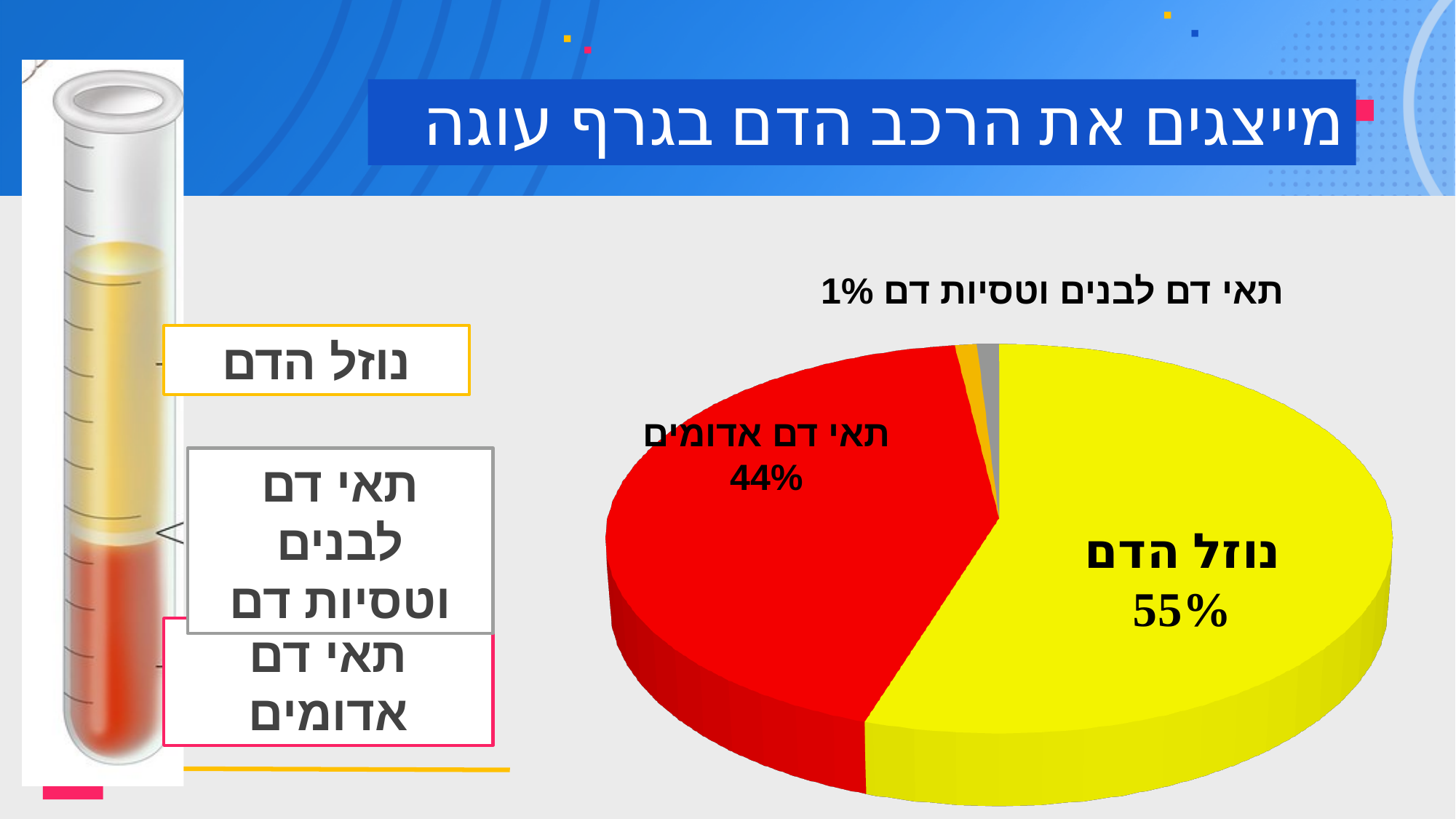
Which category has the smallest slice of the pie? תאי דם לבנים וטסיות דם What share of the pie does נוזל הדם (blood plasma) represent? 55% What share of the pie does תאי דם לבנים וטסיות דם (white blood cells and platelets) represent? 1% Which is larger, the slice for נוזל הדם or the slice for תאי דם אדומים? נוזל הדם What type of chart is shown on the slide? pie chart What colour is the slice for נוזל הדם in the pie chart? yellow Which category has the largest slice of the pie? נוזל הדם What share of the pie does תאי דם אדומים (red blood cells) represent? 44% What is the difference in percentage points between נוזל הדם and תאי דם אדומים? 11 What is the difference in percentage points between תאי דם אדומים and תאי דם לבנים וטסיות דם? 43 What is the title of the slide containing the pie chart? מייצגים את הרכב הדם בגרף עוגה